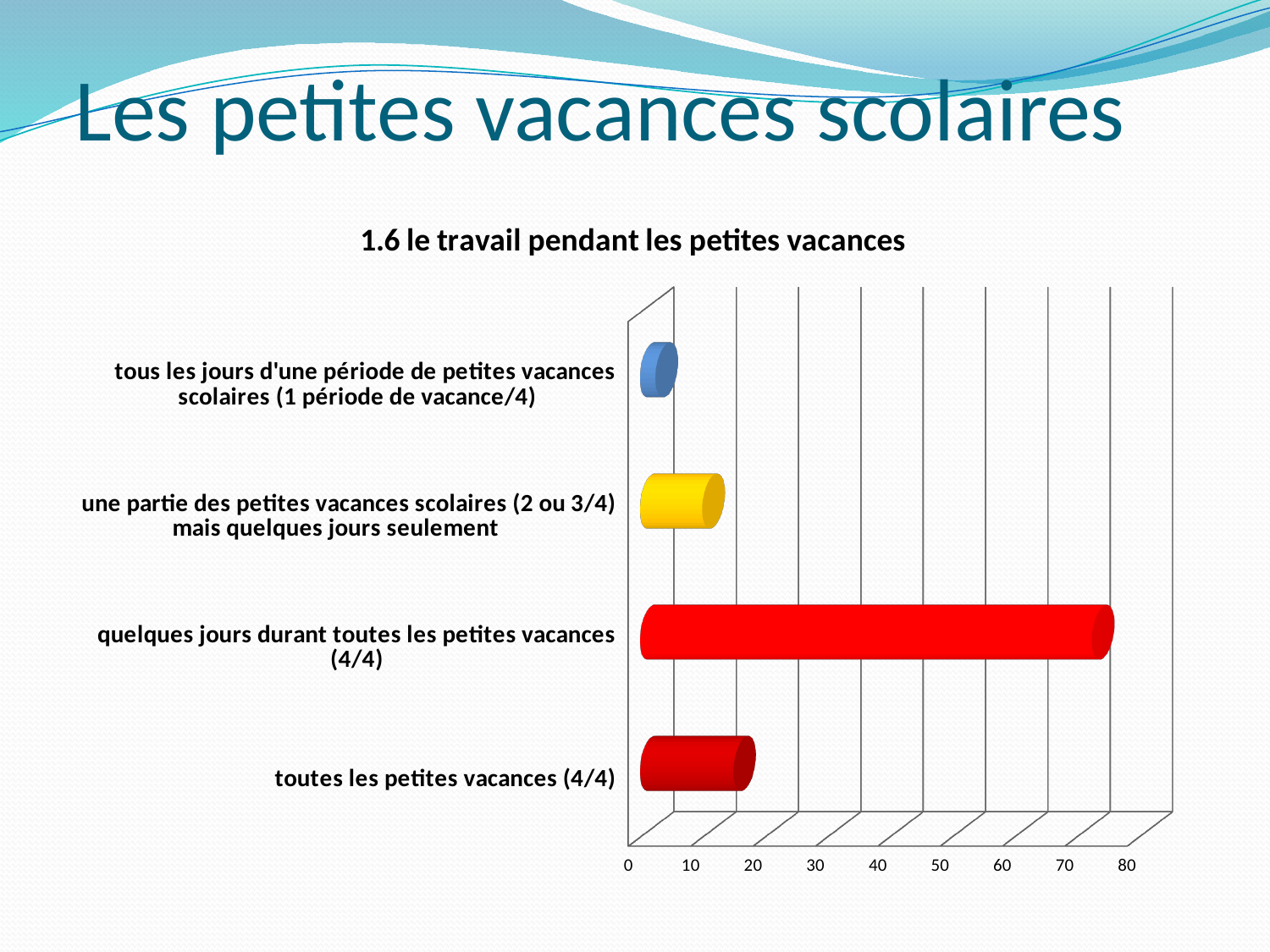
Is the value for 'tous les jours d'une période de petites vacances scolaires (1 période de vacance/4)' greater or less than 10? less Which is larger: the value for 'toutes les petites vacances (4/4)' or the value for 'une partie des petites vacances scolaires (2 ou 3/4) mais quelques jours seulement'? toutes les petites vacances (4/4) Is the value for 'toutes les petites vacances (4/4)' greater or less than 20? less What is the title of the chart? 1.6 le travail pendant les petites vacances Which category has the lowest value? tous les jours d'une période de petites vacances scolaires (1 période de vacance/4) What colour is the bar for 'une partie des petites vacances scolaires (2 ou 3/4) mais quelques jours seulement'? yellow Is the value for 'quelques jours durant toutes les petites vacances (4/4)' greater or less than 70? greater How many categories are plotted in the chart? 4 What kind of chart is shown on the slide? bar chart Which category has the highest value? quelques jours durant toutes les petites vacances (4/4)